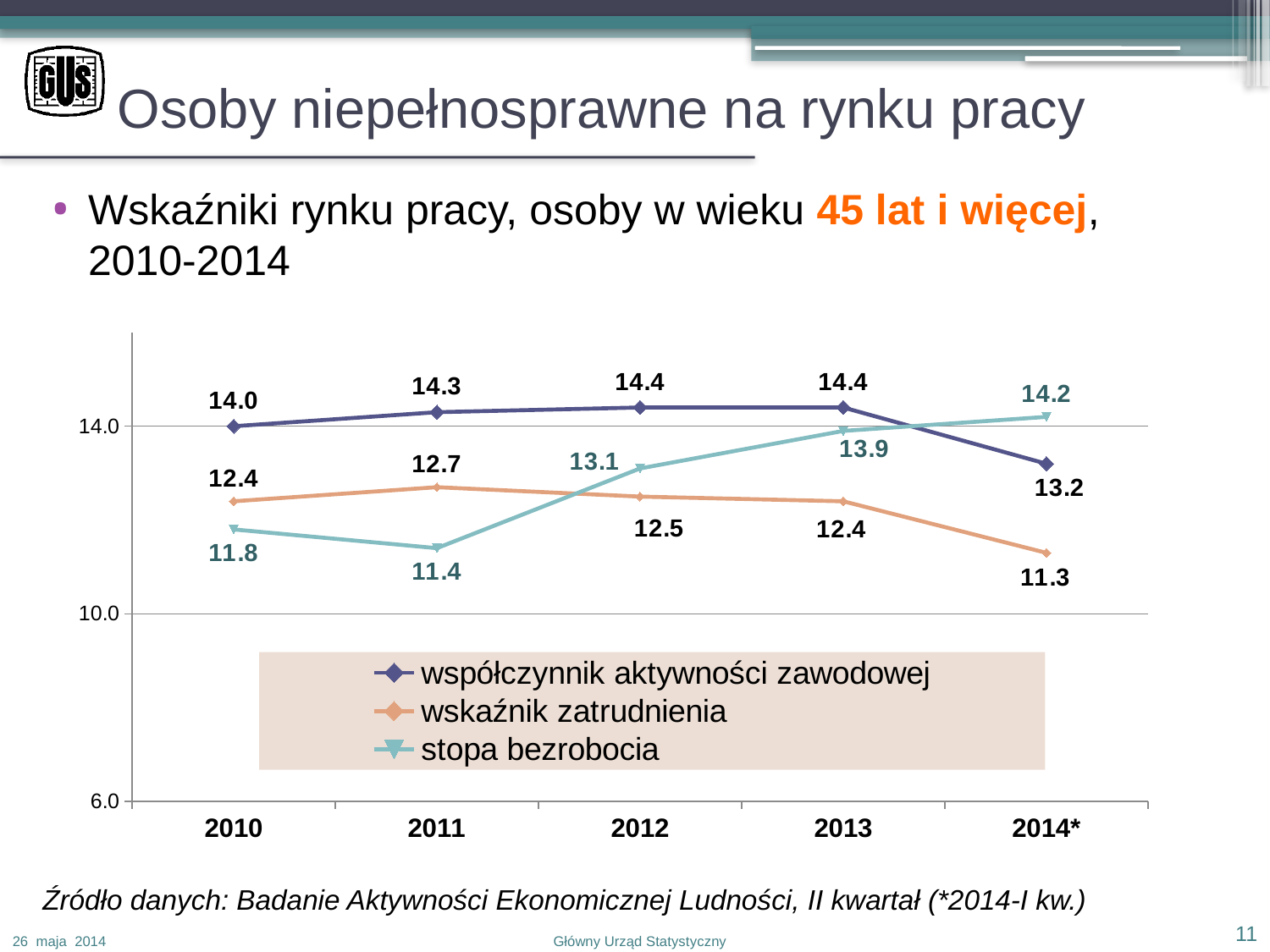
Which is larger in 2014*: stopa bezrobocia or współczynnik aktywności zawodowej? stopa bezrobocia Does stopa bezrobocia rise or fall from 2011 to 2014*? rise Which series is drawn with the orange line? wskaźnik zatrudnienia In which year is wskaźnik zatrudnienia highest? 2011 How many series does the legend list? 3 What is the value of współczynnik aktywności zawodowej in 2011? 14.3 What is the value of stopa bezrobocia in 2012? 13.1 How many years are shown on the x axis? 5 What is the value of wskaźnik zatrudnienia in 2014*? 11.3 What type of chart is shown on the slide? line chart What is the difference between współczynnik aktywności zawodowej and wskaźnik zatrudnienia in 2010? 1.6 In which year is stopa bezrobocia lowest? 2011